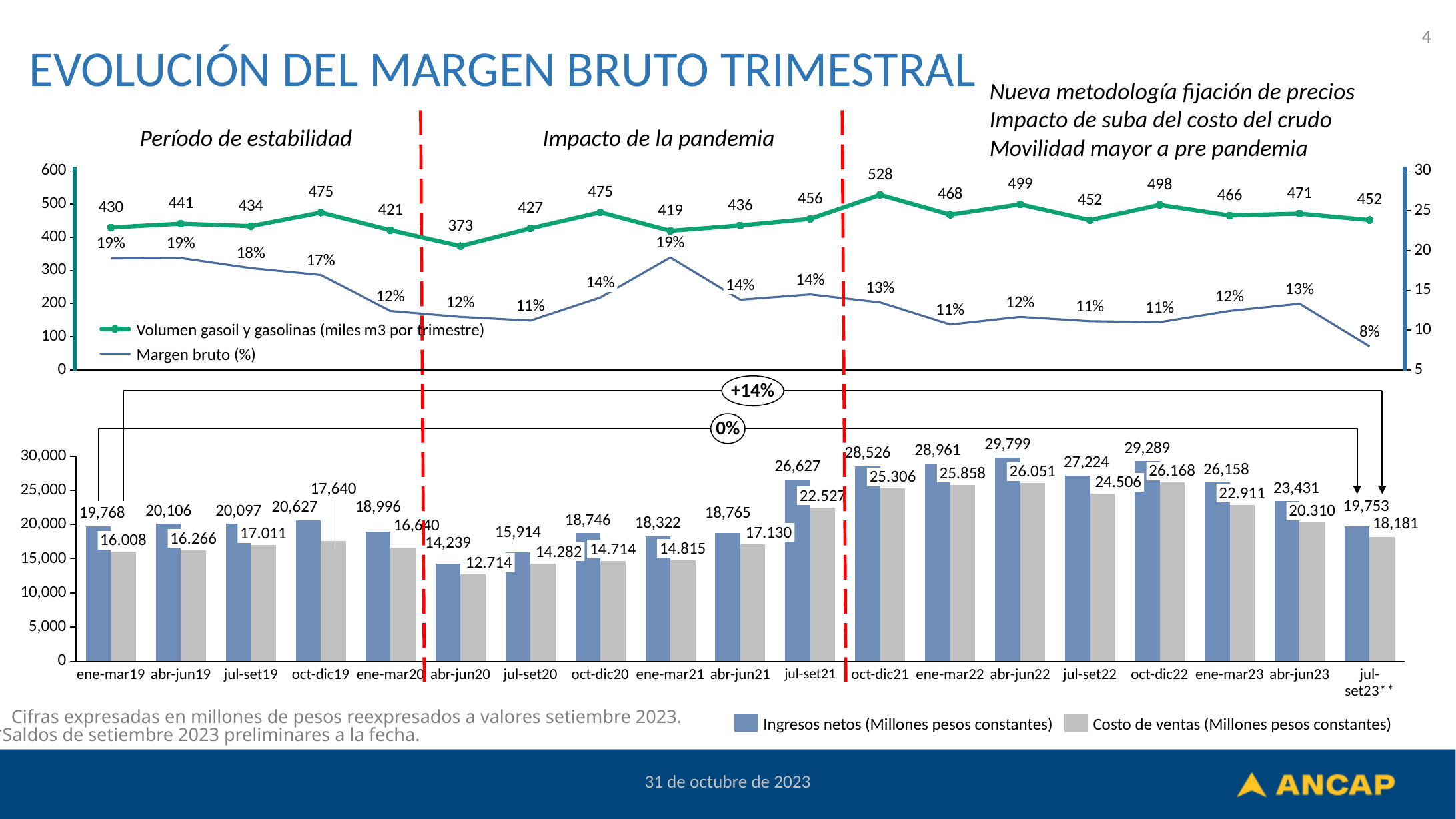
In the top line chart, what is the highest value of Volumen gasoil y gasolinas, and in which quarter does it occur? 528, oct-dic21 In the bottom bar chart, which is larger: Ingresos netos for oct-dic21 or for ene-mar22? ene-mar22 What kind of chart is the top chart on the slide? Line chart In the bottom bar chart, which quarter has the lowest Ingresos netos? abr-jun20 In the top line chart, what is the lowest value of Volumen gasoil y gasolinas? 373 In the top line chart, what is the Margen bruto (%) for jul-set23? 8% How many quarters are shown on the x axis of the bottom bar chart? 19 In the top line chart, what is the Volumen gasoil y gasolinas for oct-dic19? 475 In the bottom bar chart, what is the value of Costo de ventas for abr-jun20? 12.714 In the bottom bar chart, what is the difference between Ingresos netos in abr-jun22 and abr-jun20? 15,560 In the bottom bar chart, what is the value of Ingresos netos for abr-jun22? 29,799 How many series does the legend of the top chart list? 2